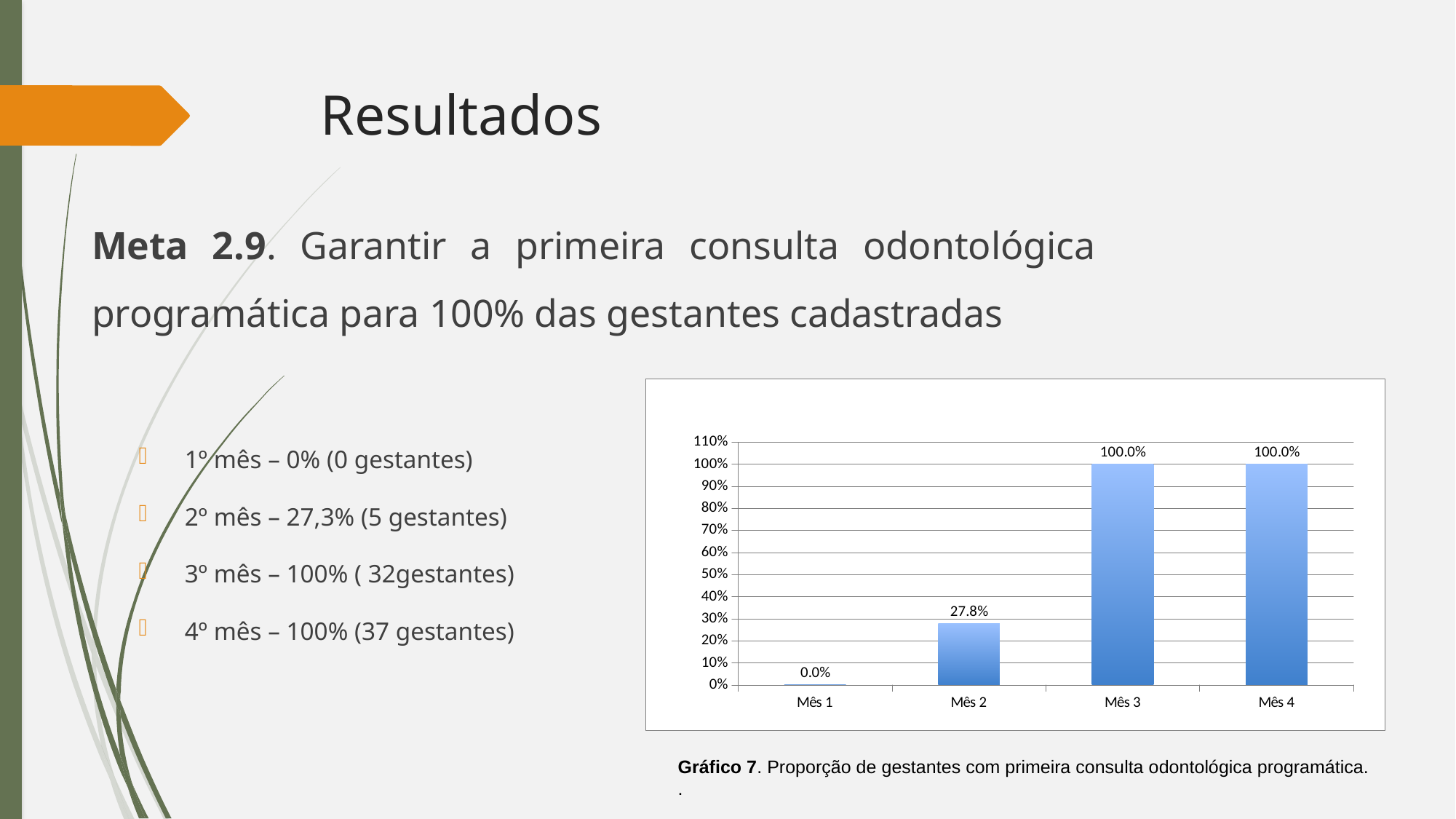
What is the value for Mês 3 in the chart? 100.0% Do the values rise or fall from Mês 1 to Mês 3? rise Is the value for Mês 2 greater or less than 30%? less Which is larger, the value for Mês 2 or the value for Mês 4? Mês 4 How many months are shown on the x axis of the chart? 4 What is the value for Mês 2 in the chart? 27.8% What is the difference between the values for Mês 3 and Mês 2? 72.2% What is the caption number of the chart (Gráfico)? Gráfico 7 What is the highest value shown on the y axis of the chart? 110% Which month has the lowest value in the chart? Mês 1 What is the value for Mês 1 in the chart? 0.0% What kind of chart is shown on the slide? bar chart